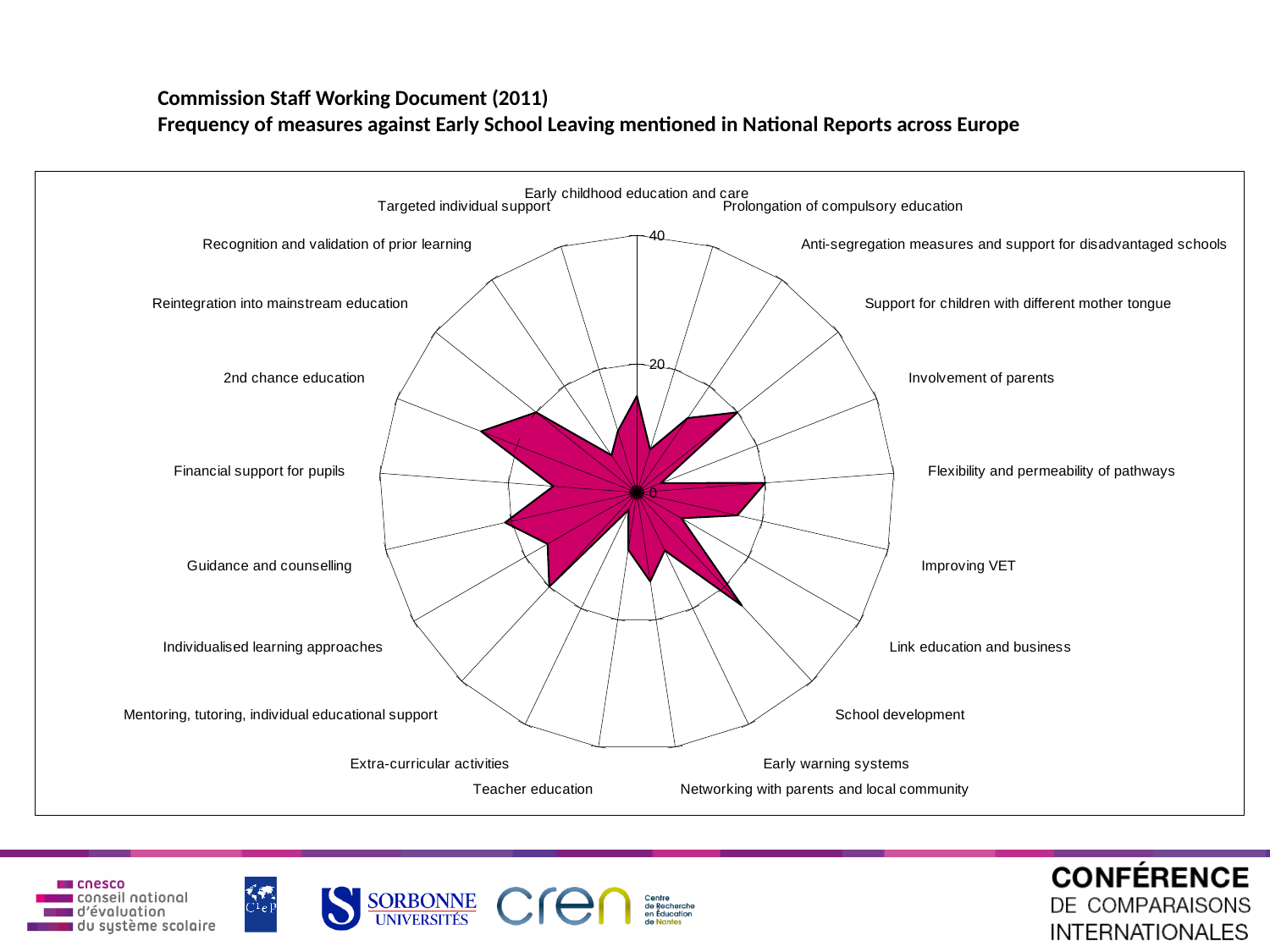
Is the value for Teacher education greater or less than 20? less Is the value for School development greater or less than 20? greater Is the value for 2nd chance education greater or less than 40? less How many measures (categories) are plotted on the radar chart? 21 According to the slide title, what does the chart show the frequency of? Measures against Early School Leaving mentioned in National Reports across Europe What kind of chart is shown on the slide? Radar chart What is the highest tick value shown on the radar chart's axis? 40